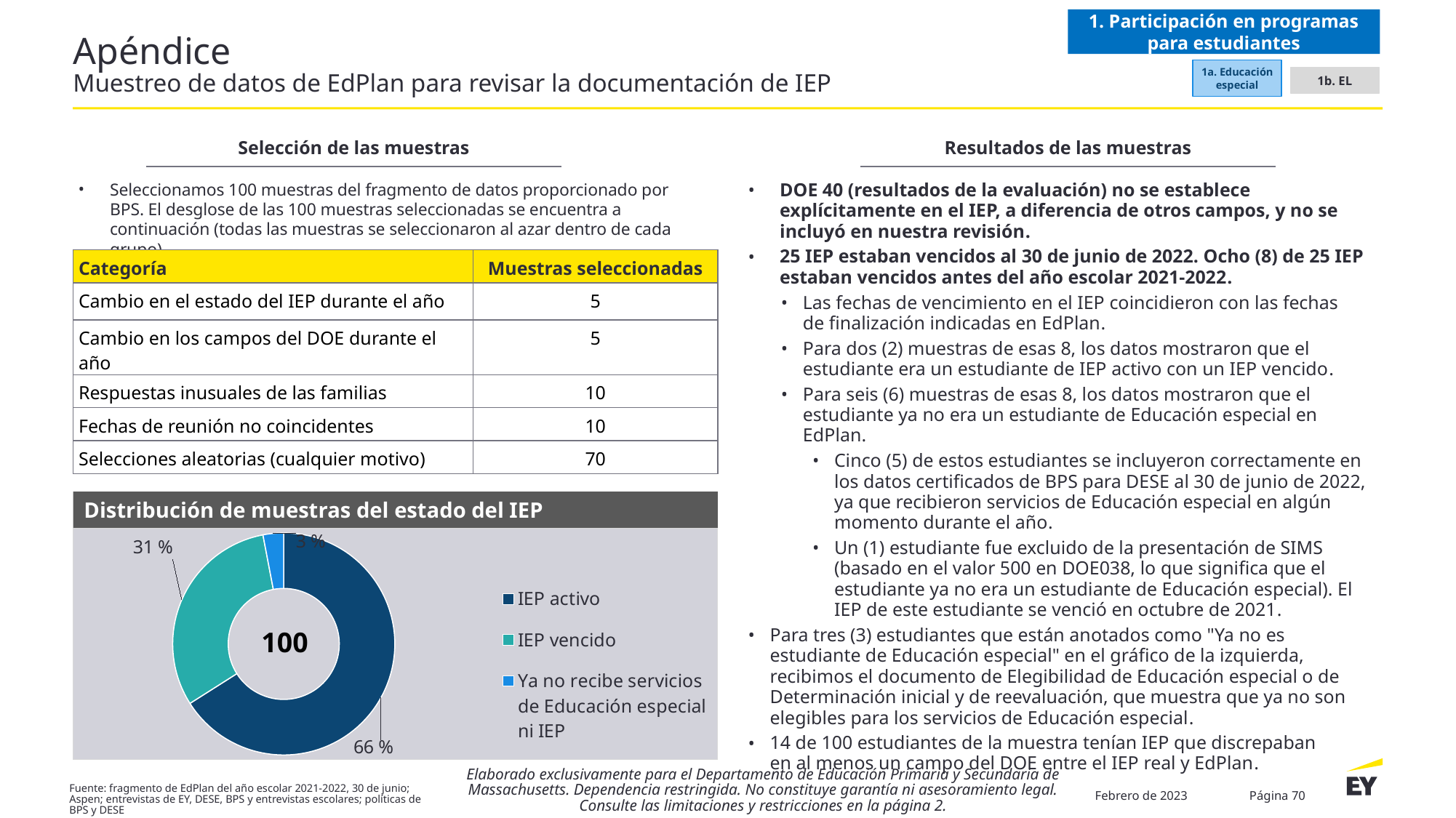
In the chart "Distribución de muestras del estado del IEP", what percentage is shown for "IEP vencido"? 31 % In the chart "Distribución de muestras del estado del IEP", what is the difference in percentage points between "IEP activo" and "IEP vencido"? 35 How many categories does the legend of the chart "Distribución de muestras del estado del IEP" list? 3 In the chart "Distribución de muestras del estado del IEP", what percentage is shown for "Ya no recibe servicios de Educación especial ni IEP"? 3 % In the chart "Distribución de muestras del estado del IEP", which is larger: "IEP vencido" or "Ya no recibe servicios de Educación especial ni IEP"? IEP vencido In the chart "Distribución de muestras del estado del IEP", what colour represents "IEP vencido"? Teal (green) What number is displayed in the center of the donut chart "Distribución de muestras del estado del IEP"? 100 Which category has the smallest slice in the chart "Distribución de muestras del estado del IEP"? Ya no recibe servicios de Educación especial ni IEP In the chart "Distribución de muestras del estado del IEP", what percentage is shown for "IEP activo"? 66 % What kind of chart is shown under the title "Distribución de muestras del estado del IEP"? Pie chart (donut) Which category has the largest slice in the chart "Distribución de muestras del estado del IEP"? IEP activo